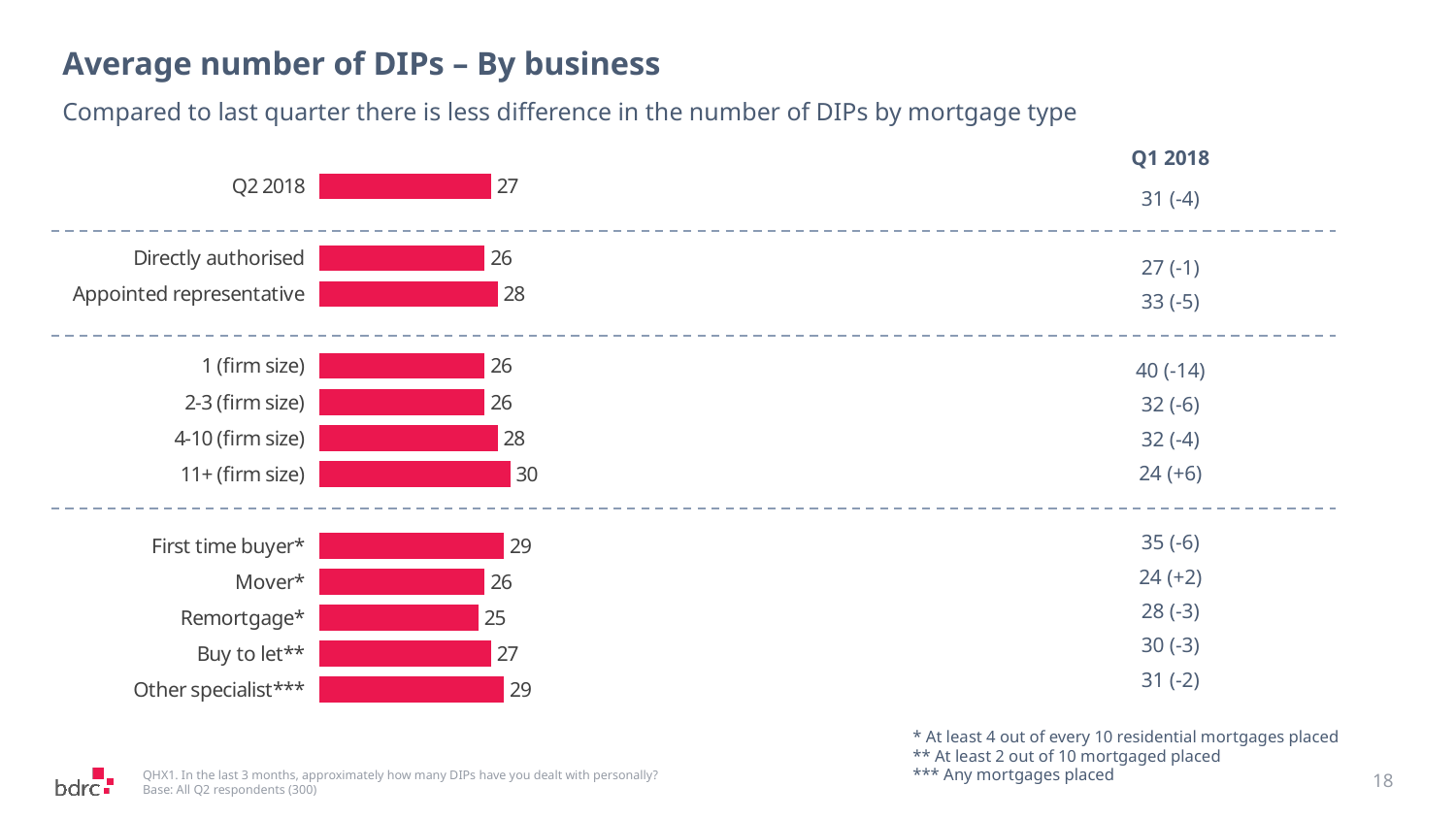
What kind of chart is shown on the slide? Bar chart What is the value shown for 11+ (firm size)? 30 How many bars are plotted on the chart? 12 What is the value shown for Appointed representative? 28 What is the average number of DIPs for Q2 2018 overall? 27 What is the difference between the values for 11+ (firm size) and 1 (firm size)? 4 What Q1 2018 value is listed next to 1 (firm size)? 40 (-14) What is the title of the chart on the slide? Average number of DIPs – By business Which category has the highest bar on the chart? 11+ (firm size) Which category has the lowest bar on the chart? Remortgage* What is the value shown for Remortgage*? 25 Which is larger, the value for First time buyer* or the value for Mover*? First time buyer*